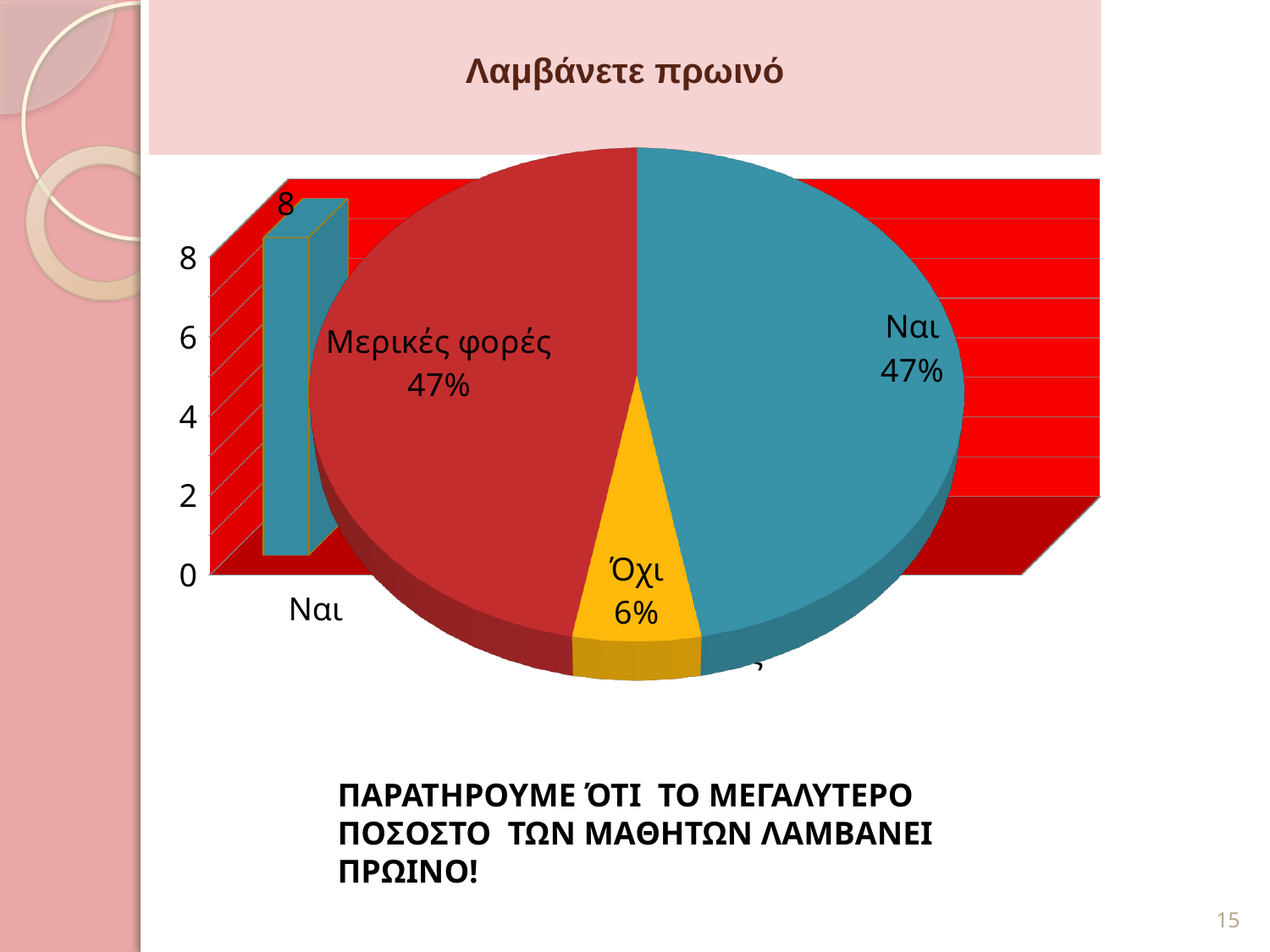
In the pie chart, which is larger, the Ναι slice or the Όχι slice? Ναι In the pie chart, what share is shown for Μερικές φορές? 47% In the pie chart, which slice is the smallest? Όχι What kind of chart is the chart in the background behind the pie? Bar chart In the pie chart, what share is shown for Όχι? 6% What kind of chart is the chart in the foreground of the slide? Pie chart In the pie chart, what is the difference in percentage points between the Ναι slice and the Όχι slice? 41 percentage points What is the title shown above the charts? Λαμβάνετε πρωινό In the pie chart, what share of the pie does the Ναι slice represent? 47% In the bar chart behind the pie, is the value for Ναι greater or less than 6? greater In the bar chart behind the pie, what is the value of the bar for Ναι? 8 How many slices does the pie chart have? 3